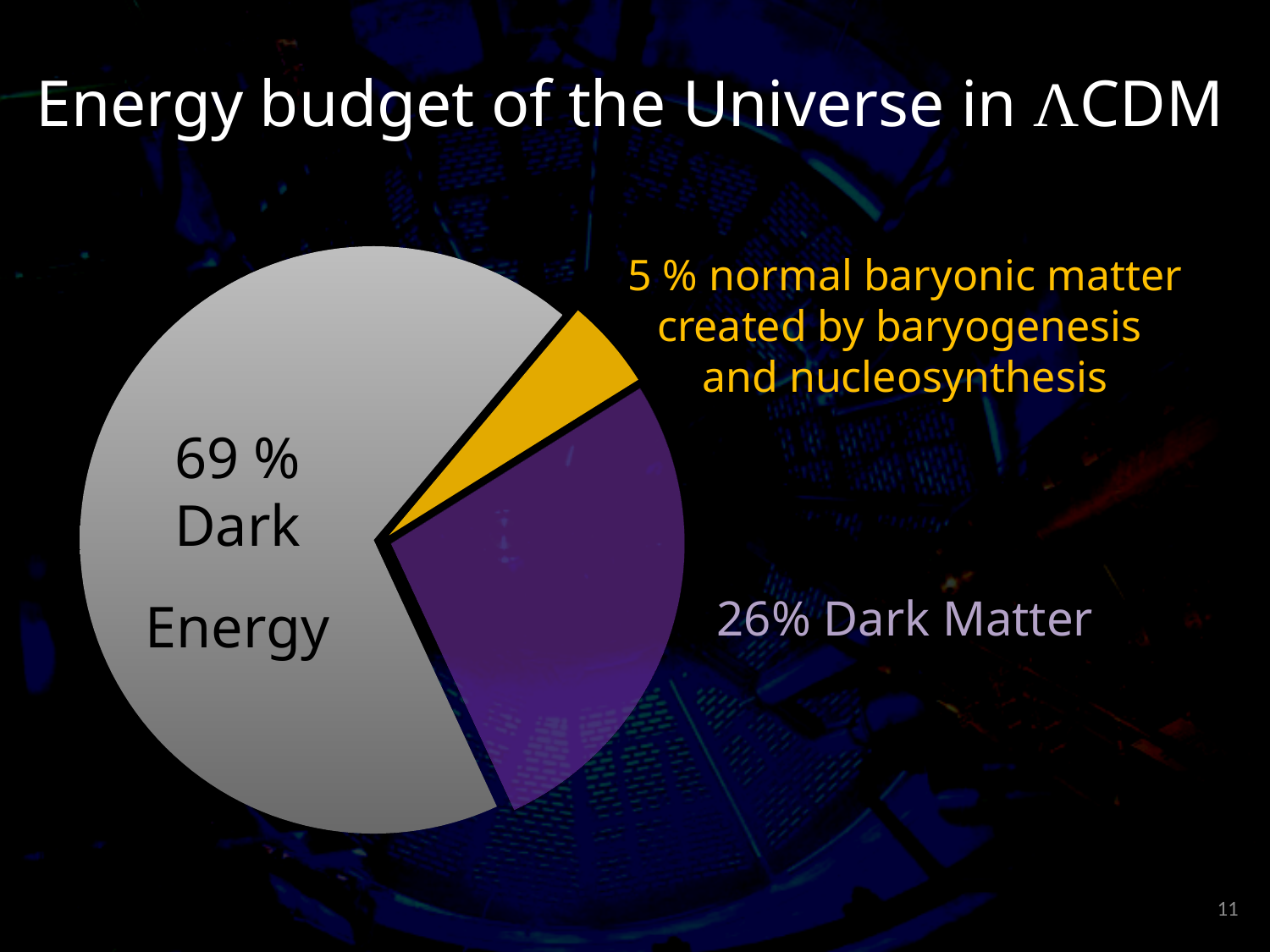
What share of the energy budget is Dark Energy? 69 % What share of the energy budget is Dark Matter? 26% Which component has the smallest share of the pie? normal baryonic matter How many slices does the pie chart have? 3 What share of the energy budget is normal baryonic matter? 5 % Which is larger, the Dark Matter share or the normal baryonic matter share? Dark Matter What kind of chart is shown on the slide? pie chart What colour is the Dark Matter slice? purple What is the difference in percentage points between Dark Energy and Dark Matter? 43 What is the difference in percentage points between Dark Matter and normal baryonic matter? 21 What is the title of the slide? Energy budget of the Universe in ΛCDM Which component has the largest share of the pie? Dark Energy